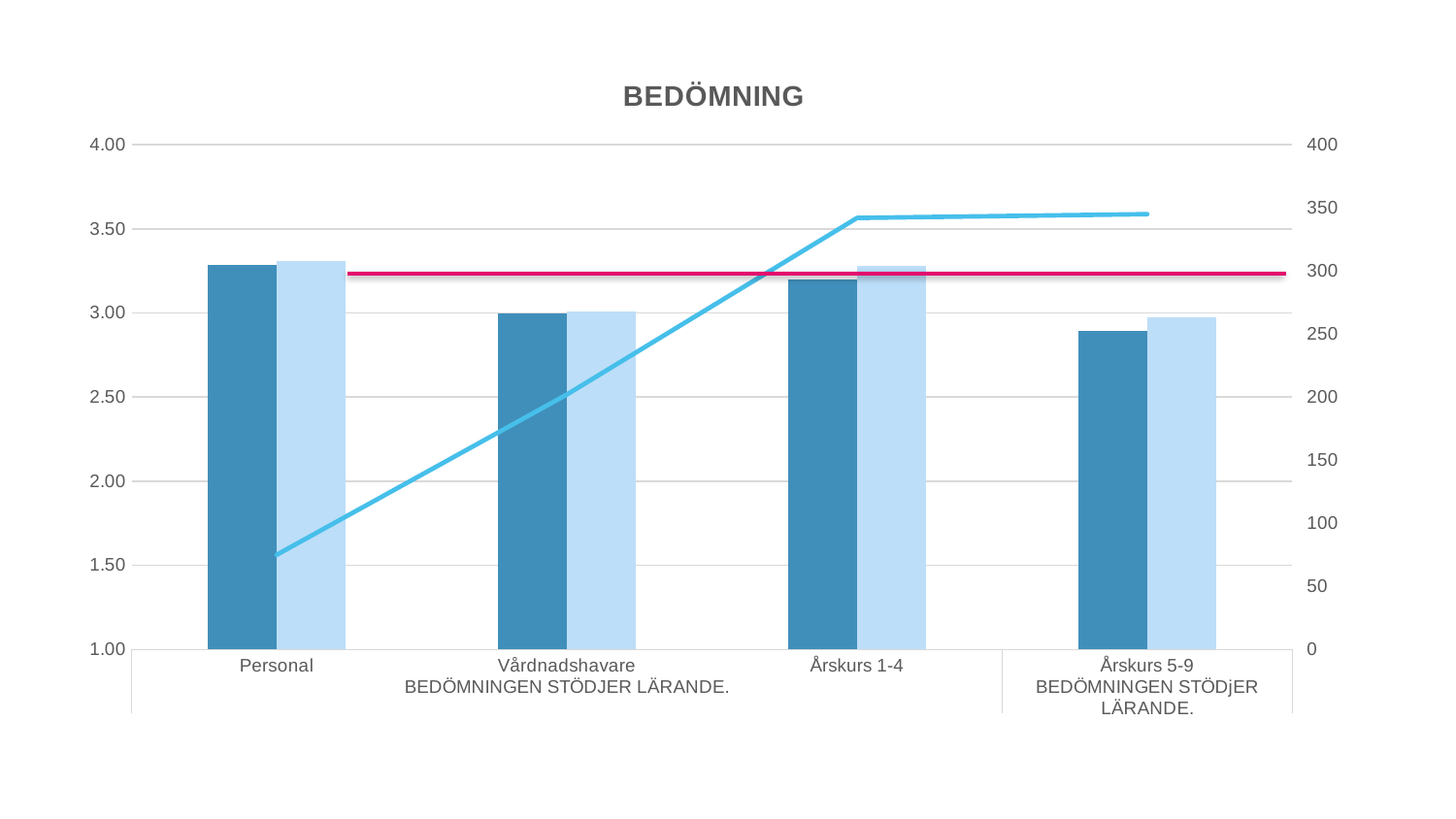
Which category has the lowest light blue bar? Årskurs 5-9 Is the dark blue bar for Personal greater or less than 3.00 on the left axis? greater What kind of chart is this? Bar chart with line series Which dark blue bar is taller, Personal or Vårdnadshavare? Personal Is the light blue line value for Personal greater or less than 100 on the right axis? less Does the light blue line rise or fall from Personal to Årskurs 5-9? rise How many categories are shown on the x axis of the chart? 4 Which category has the lowest dark blue bar? Årskurs 5-9 Is the dark blue bar for Årskurs 5-9 greater or less than 3.00 on the left axis? less What is the title of the chart? BEDÖMNING Which category has the highest dark blue bar? Personal